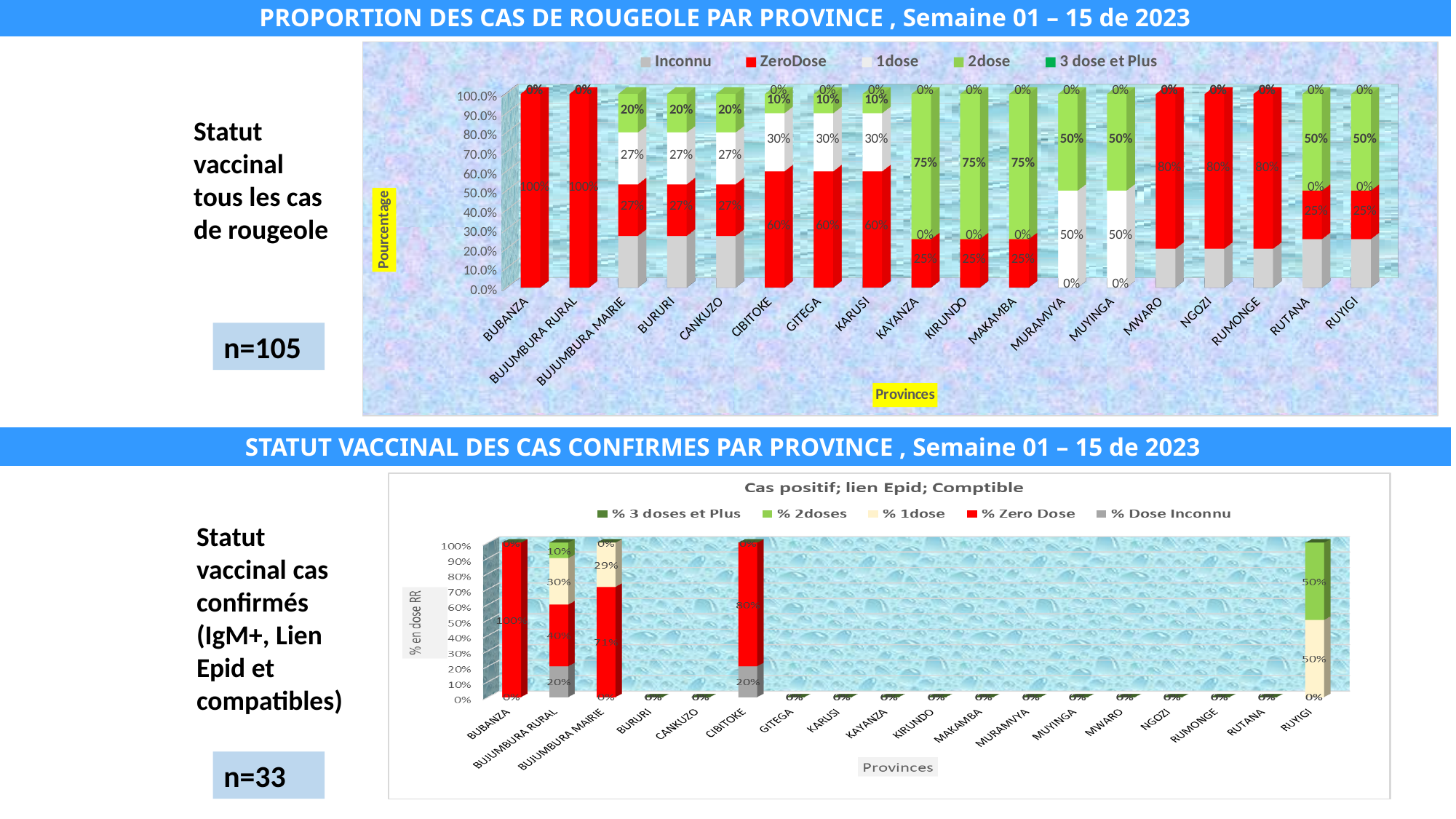
In the top chart (PROPORTION DES CAS DE ROUGEOLE PAR PROVINCE), what is the 2dose percentage for KAYANZA? 75% What kind of chart is the top chart (PROPORTION DES CAS DE ROUGEOLE PAR PROVINCE)? Stacked bar chart In the top chart (PROPORTION DES CAS DE ROUGEOLE PAR PROVINCE), which province has the larger ZeroDose share, CIBITOKE or KAYANZA? CIBITOKE In the bottom chart (Cas positif; lien Epid; Comptible), what is the % 1dose for BUJUMBURA RURAL? 30% In the bottom chart (Cas positif; lien Epid; Comptible), what is the % Dose Inconnu for CIBITOKE? 20% In the bottom chart (Cas positif; lien Epid; Comptible), what is the % 2doses for RUYIGI? 50% In the bottom chart (Cas positif; lien Epid; Comptible), what is the difference in % Zero Dose between BUJUMBURA MAIRIE and BUJUMBURA RURAL? 31% In the top chart (PROPORTION DES CAS DE ROUGEOLE PAR PROVINCE), what is the ZeroDose percentage for BUBANZA? 100% In the top chart (PROPORTION DES CAS DE ROUGEOLE PAR PROVINCE), what is the 1dose percentage for CIBITOKE? 30% In the top chart (PROPORTION DES CAS DE ROUGEOLE PAR PROVINCE), how many provinces are shown on the x axis? 18 In the bottom chart (Cas positif; lien Epid; Comptible), what is the % Zero Dose for BUJUMBURA MAIRIE? 71% In the top chart (PROPORTION DES CAS DE ROUGEOLE PAR PROVINCE), how many series does the legend list? 5